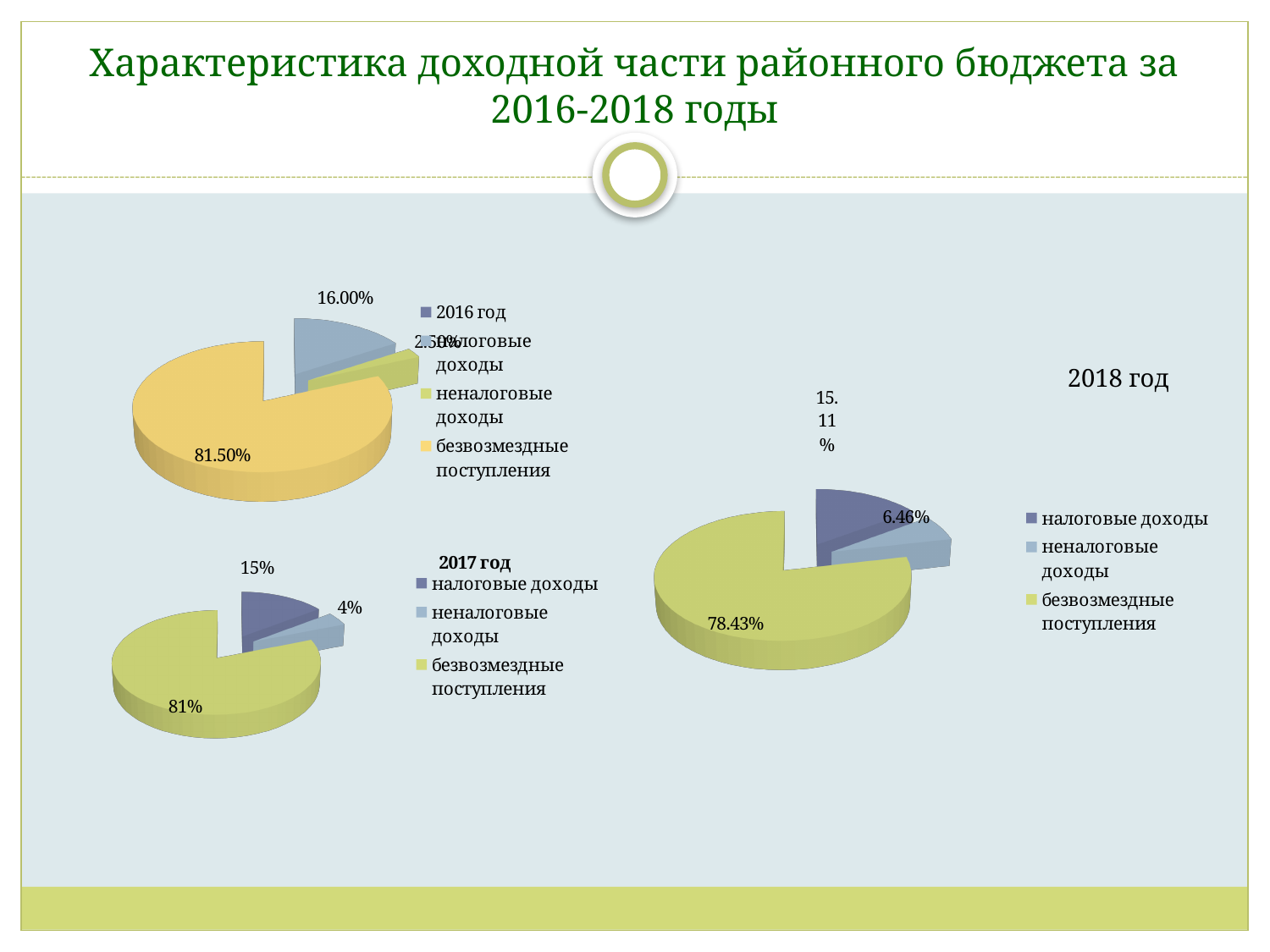
In the 2018 год pie chart, what is the difference between the shares of налоговые доходы and неналоговые доходы? 8.65% How many categories does the 2017 год pie chart show? 3 In the 2016 год pie chart, what is the share for налоговые доходы? 16.00% In the 2017 год pie chart, what is the share for безвозмездные поступления? 81% What type of chart is used for the 2018 год data? pie chart In the 2017 год pie chart, what is the share for налоговые доходы? 15% In the 2016 год pie chart, what is the share for безвозмездные поступления? 81.50% In the 2018 год pie chart, what is the share for налоговые доходы? 15.11% In the 2017 год pie chart, which category has the smallest slice? неналоговые доходы In the 2017 год pie chart, what is the share for неналоговые доходы? 4% In the 2018 год pie chart, what is the share for неналоговые доходы? 6.46% In the 2018 год pie chart, which category has the largest slice? безвозмездные поступления